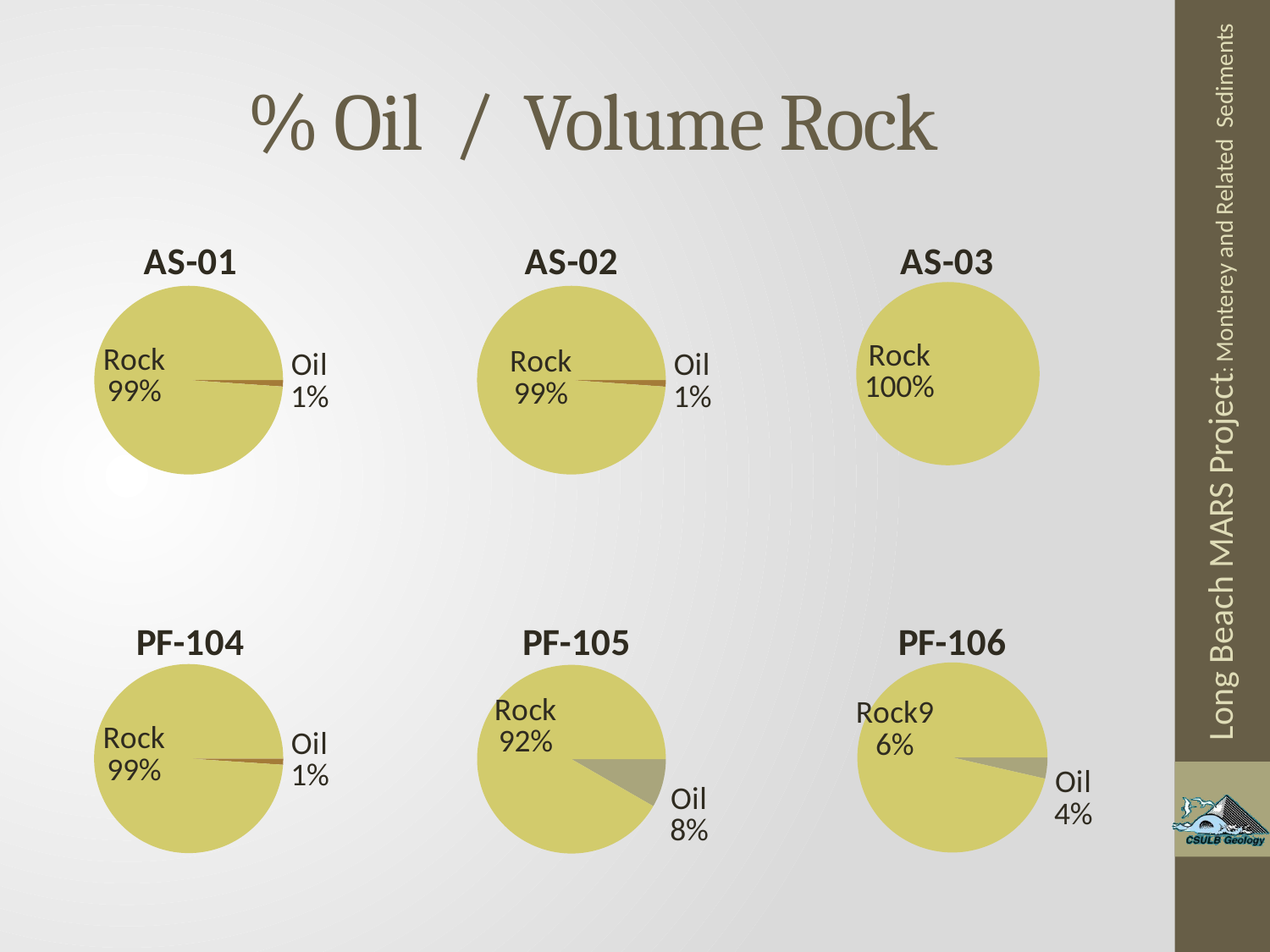
Is the Oil percentage larger in the PF-105 chart or the PF-106 chart? PF-105 In the AS-02 chart, what percentage is labelled for Rock? 99% Across the six charts, which sample has the highest Oil percentage? PF-105 In the AS-01 chart, what share of the pie is Oil? 1% In the AS-03 chart, what percentage is labelled for Rock? 100% In the PF-106 chart, what share of the pie is Oil? 4% In the PF-105 chart, what percentage is labelled for Rock? 92% In the PF-105 chart, what share of the pie is Oil? 8% What type of chart is used for each sample on this slide? Pie chart Across the six charts, which sample has the lowest Oil percentage? AS-03 In the PF-104 chart, what percentage is labelled for Oil? 1% What is the difference between the Oil percentage in the PF-105 chart and the Oil percentage in the PF-106 chart? 4%